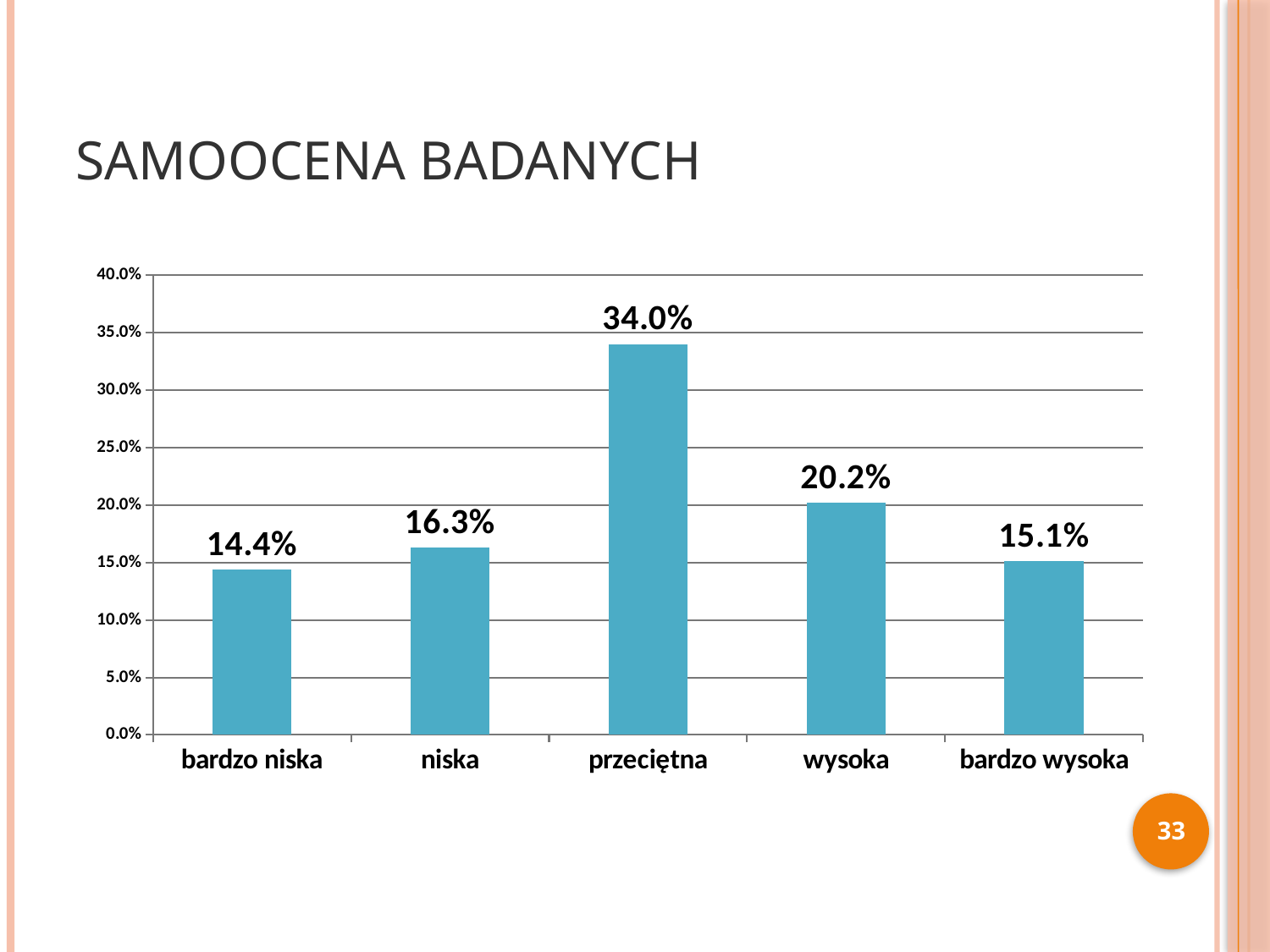
What is the title of the slide? SAMOOCENA BADANYCH What is the value for "bardzo niska"? 14.4% How many categories are shown on the x axis? 5 Which is larger, the value for "niska" or the value for "bardzo wysoka"? niska Is the value for "wysoka" greater or less than 20.0%? greater What is the value for "przeciętna"? 34.0% What is the value for "wysoka"? 20.2% Which category has the lowest value? bardzo niska Which category has the highest value? przeciętna What is the value for "bardzo wysoka"? 15.1% What is the difference between the values for "przeciętna" and "wysoka"? 13.8% What kind of chart is shown on the slide? bar chart